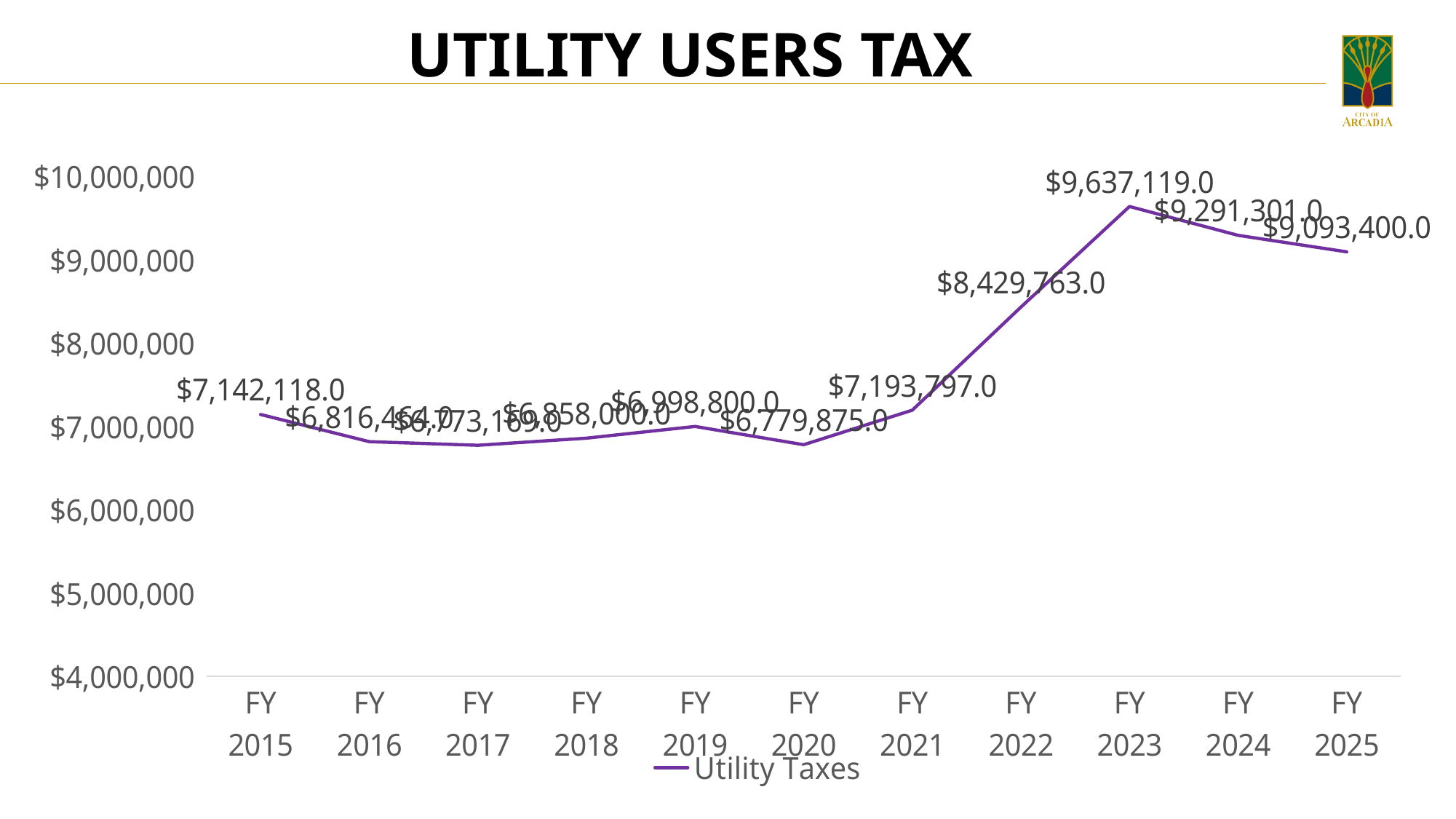
Is the Utility Taxes value for FY 2016 greater or less than $7,000,000? less What kind of chart is shown on the slide? line chart Which is larger, the Utility Taxes value for FY 2022 or for FY 2021? FY 2022 What is the Utility Taxes value for FY 2023? $9,637,119.0 What is the Utility Taxes value for FY 2025? $9,093,400.0 What is the Utility Taxes value for FY 2020? $6,779,875.0 Which fiscal year has the highest Utility Taxes value? FY 2023 Do the Utility Taxes values rise or fall from FY 2023 to FY 2025? fall How many fiscal years are plotted on the chart? 11 What is the difference between the Utility Taxes values for FY 2022 and FY 2021? $1,235,966.0 What is the difference between the Utility Taxes values for FY 2023 and FY 2024? $345,818.0 What is the Utility Taxes value for FY 2015? $7,142,118.0